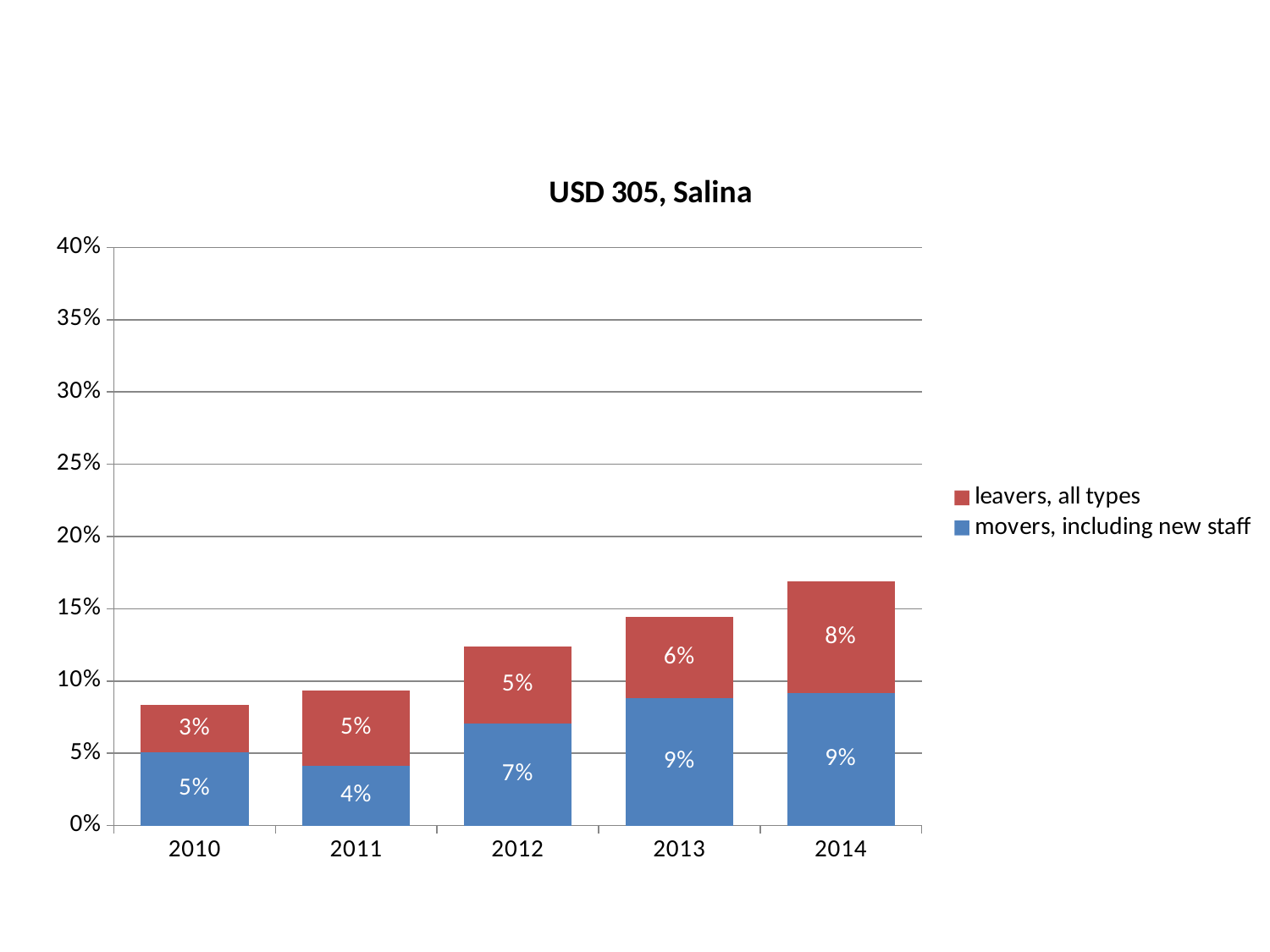
What is the difference between the leavers, all types values for 2014 and 2010? 5% How many series does the legend list? 2 In which year is the value for movers, including new staff lowest? 2011 What is the value for movers, including new staff in 2011? 4% What is the value for leavers, all types in 2013? 6% Do the total bar heights rise or fall from 2010 to 2014? rise In which year is the value for leavers, all types highest? 2014 How many years are shown on the x axis? 5 What is the value for movers, including new staff in 2012? 7% In which year is the value for leavers, all types lowest? 2010 Which is larger in 2011: the value for leavers, all types or the value for movers, including new staff? leavers, all types Is the total height of the stacked bar for 2014 greater or less than 15%? greater